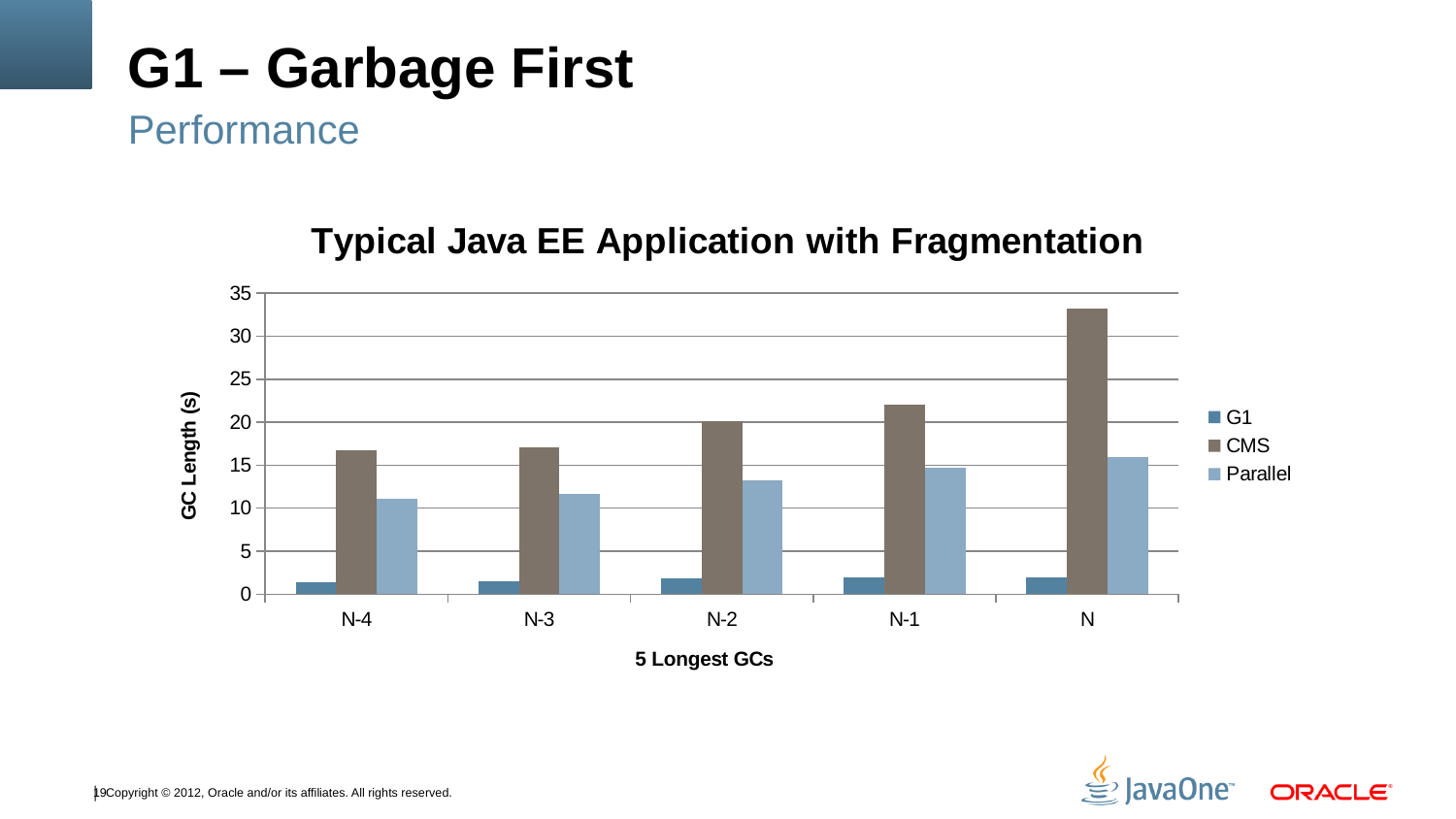
Which is larger, the CMS value at N-1 or the Parallel value at N-1? CMS How many categories are shown on the x axis? 5 What is the title of the chart? Typical Java EE Application with Fragmentation What kind of chart is shown on the slide? bar chart Is the Parallel value at N-4 greater or less than 15? less Do the CMS values rise or fall from N-4 to N? rise Which series has the highest value at category N? CMS Is the CMS value at N greater or less than 30? greater What is the label of the y axis? GC Length (s) How many series does the legend list? 3 Is the G1 value at N-2 greater or less than 5? less Which series has the lowest value at category N-4? G1